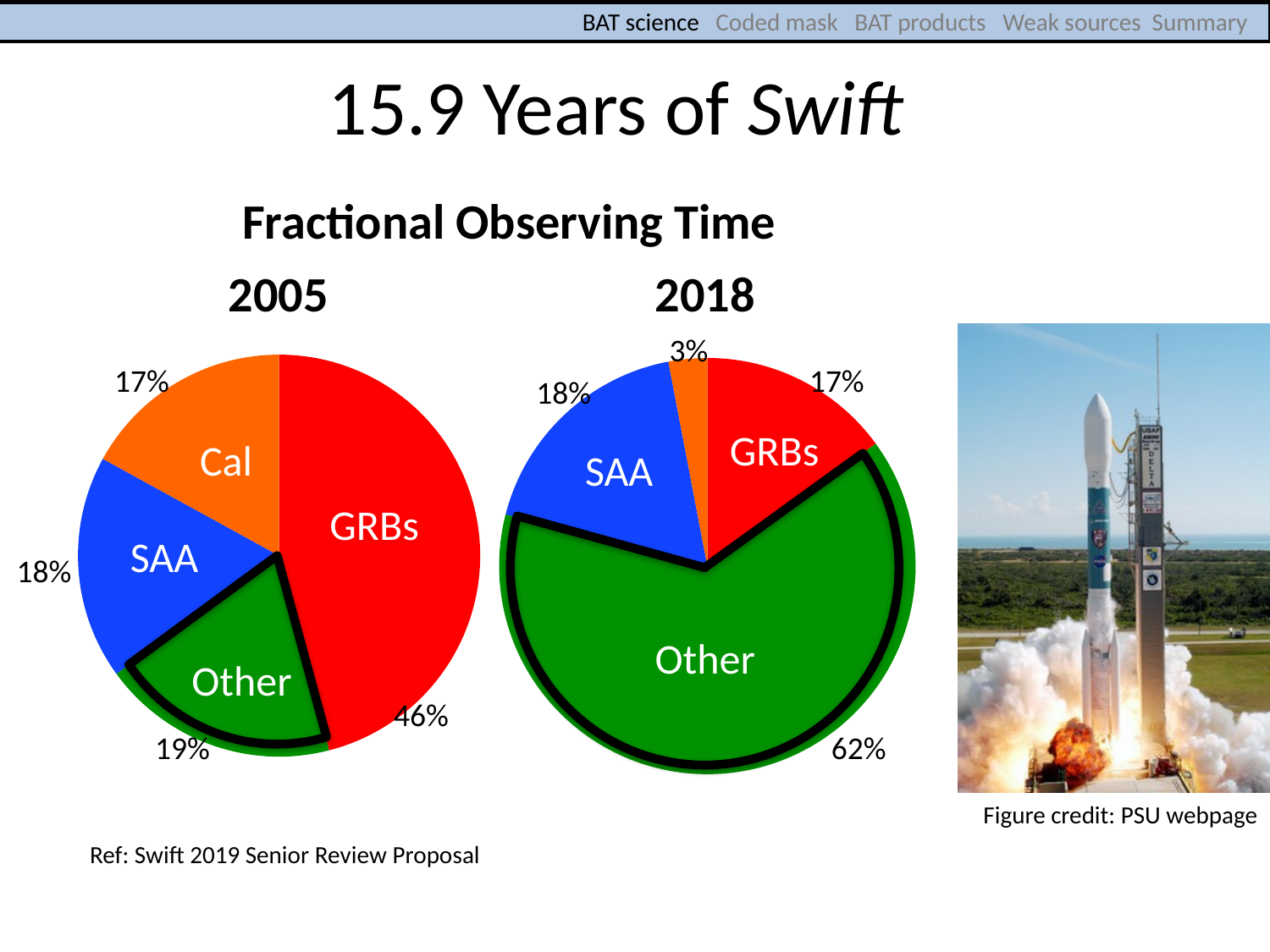
In the 2018 pie chart, what percentage is shown for the Other slice? 62% In the 2005 pie chart, what share of observing time is labelled for GRBs? 46% In the 2018 pie chart, what percentage is shown for GRBs? 17% Which year's pie chart shows a larger share for GRBs, 2005 or 2018? 2005 In the 2018 pie chart, what percentage is shown for SAA? 18% What type of charts are shown on the slide? Pie charts By how many percentage points did the Other share increase from the 2005 pie chart to the 2018 pie chart? 43 percentage points In the 2018 pie chart, which category has the largest slice? Other In the 2005 pie chart, what percentage is shown for Cal? 17% In the 2005 pie chart, which category has the largest slice? GRBs In the 2005 pie chart, what percentage is shown for the Other slice? 19% In the 2018 pie chart, what percentage is shown for the smallest slice? 3%